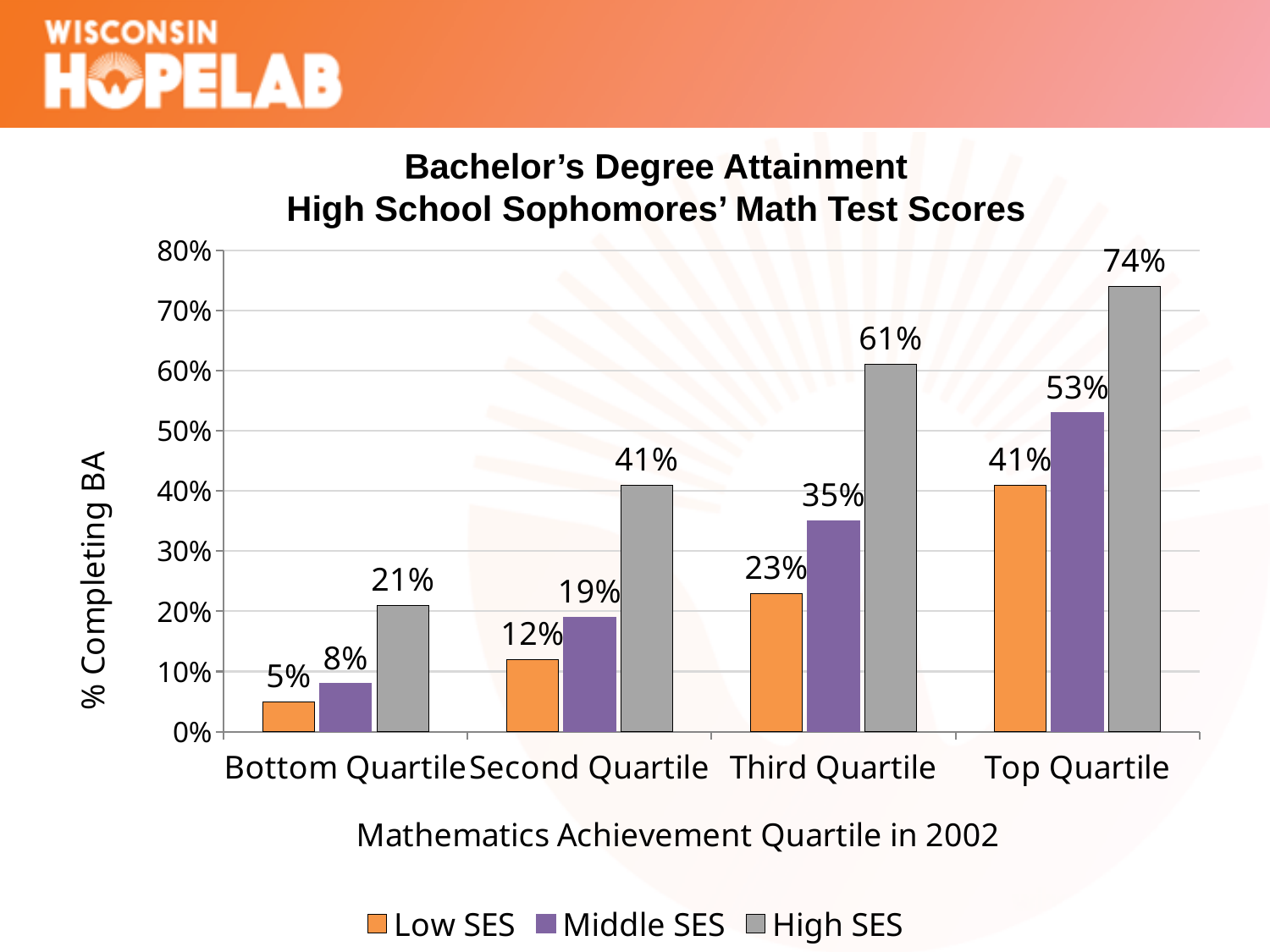
What kind of chart is shown on the slide? Bar chart How many series does the legend list? 3 Which quartile has the highest value for Low SES? Top Quartile Which quartile has the lowest value for High SES? Bottom Quartile What is the value for Low SES in the Bottom Quartile? 5% Which is larger: Middle SES in the Second Quartile or Low SES in the Third Quartile? Low SES in the Third Quartile What is the value for Middle SES in the Third Quartile? 35% How many quartile categories are shown on the x axis? 4 What is the value for High SES in the Top Quartile? 74% Do the High SES values rise or fall from the Bottom Quartile to the Top Quartile? Rise What is the label of the y axis? % Completing BA What is the difference between High SES and Low SES in the Top Quartile? 33%